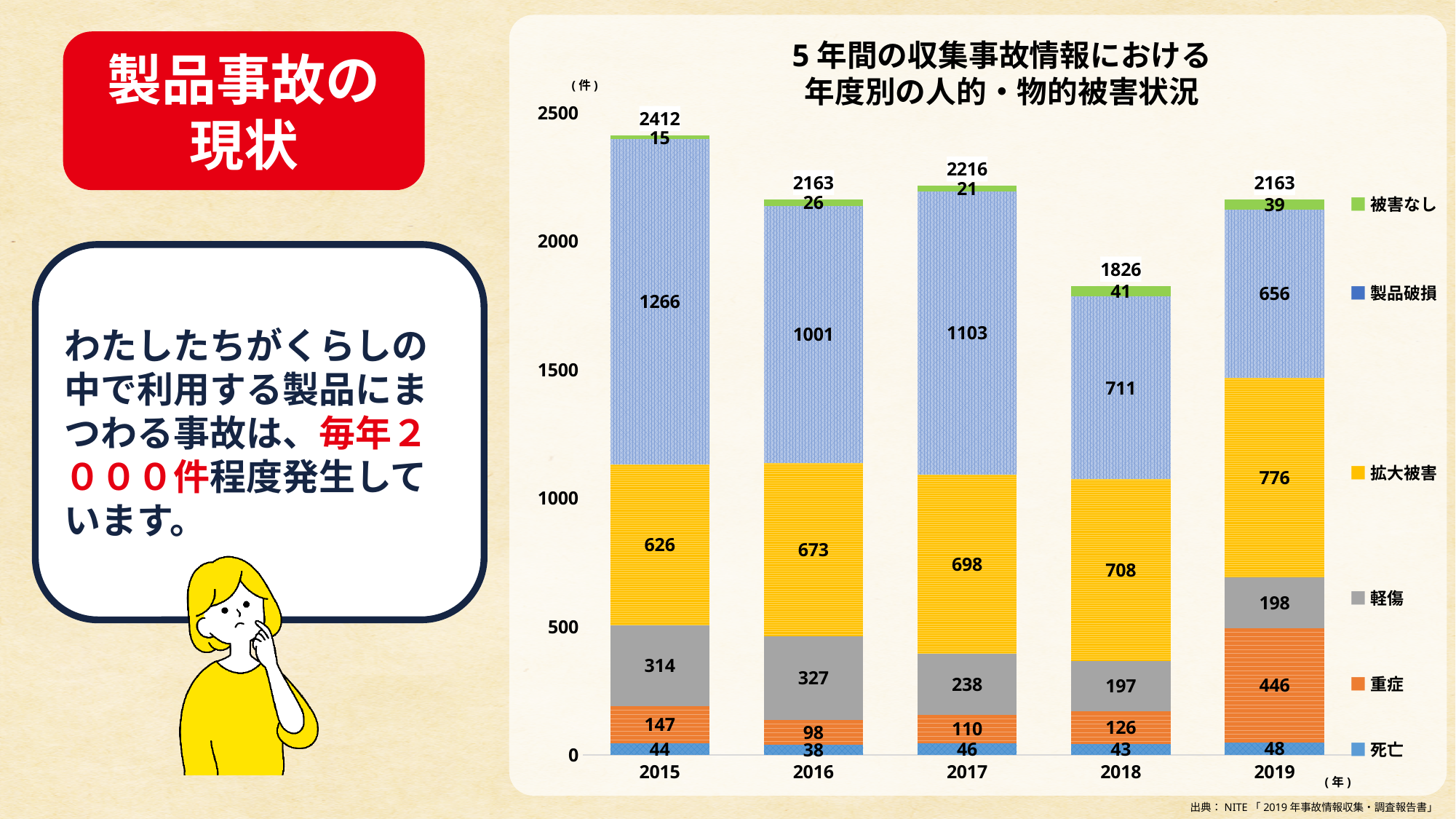
How many years are shown on the x axis of the chart? 5 What kind of chart is shown on the slide? Stacked bar chart Which year has the highest total? 2015 What is the value for 死亡 in 2016? 38 What is the value for 製品破損 in 2017? 1103 Which year has the lowest total? 2018 What is the title of the chart? 5年間の収集事故情報における年度別の人的・物的被害状況 What is the difference between the 拡大被害 values for 2019 and 2015? 150 What is the total for the 2015 bar? 2412 Which is larger, the 軽傷 value in 2016 or in 2018? 2016 How many series does the chart's legend list? 6 What is the value for 重症 in 2019? 446